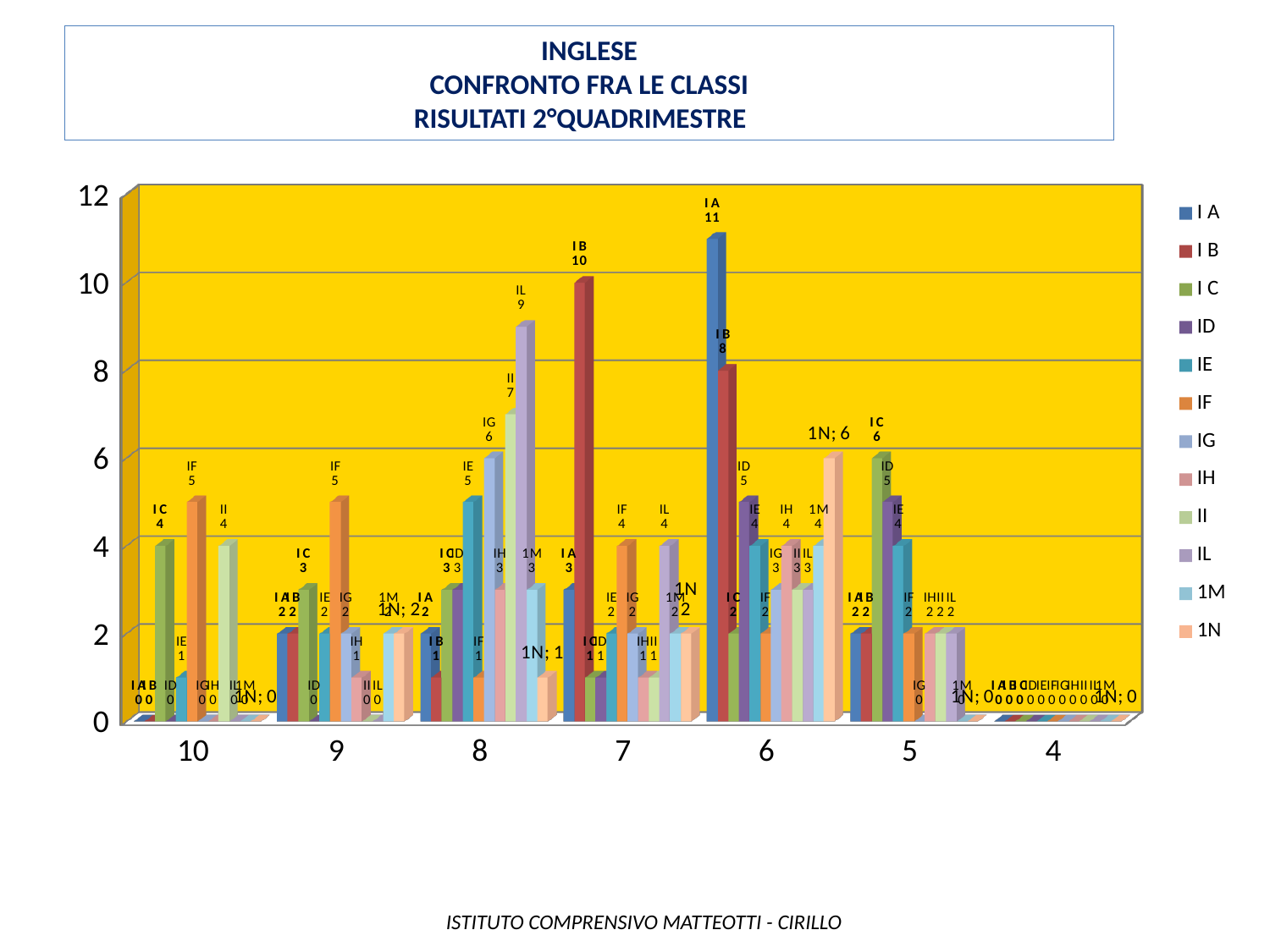
How many grade categories are shown on the x axis? 7 Which class has the highest value at grade 8? IL What is the value for I B at grade 7? 10 What is the difference between I A and I B at grade 6? 3 What is the value for 1N at grade 6? 6 What kind of chart is shown on the slide? bar chart What is the value for IL at grade 8? 9 What is the title of the chart? INGLESE CONFRONTO FRA LE CLASSI RISULTATI 2°QUADRIMESTRE What is the value for I A at grade 6? 11 How many series does the legend list? 12 Which class has the highest value at grade 6? I A At grade 10, which is larger: the value for IF or the value for I C? IF